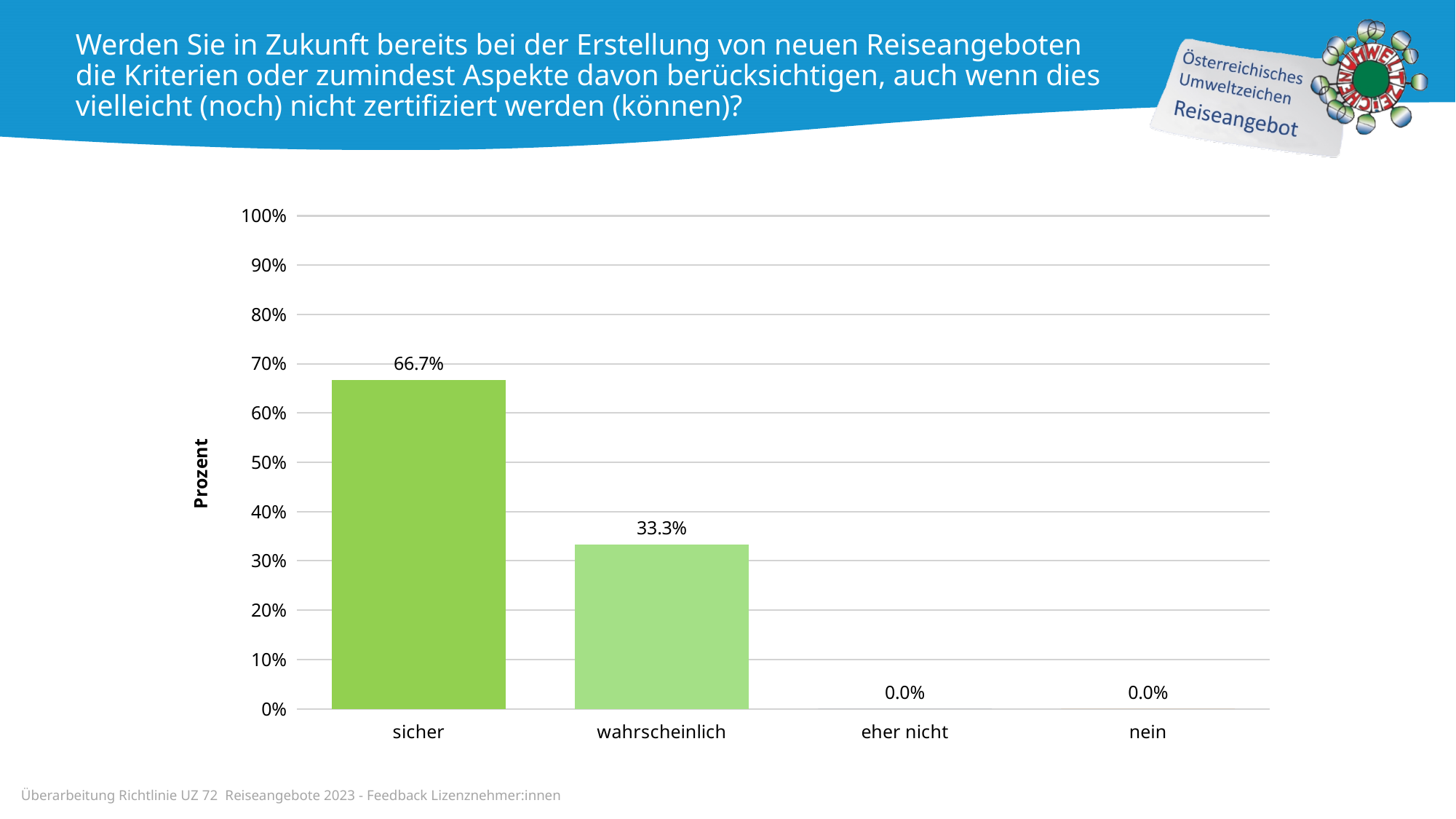
Is the value for "wahrscheinlich" greater or less than 40%? less What is the value for "eher nicht"? 0.0% What is the label of the vertical axis? Prozent Is the value for "sicher" greater or less than 60%? greater What is the difference between the values for "sicher" and "wahrscheinlich"? 33.4% What is the value for "sicher"? 66.7% How many categories are shown on the x axis? 4 Which is larger, the value for "sicher" or the value for "wahrscheinlich"? sicher What is the value for "wahrscheinlich"? 33.3% What is the value for "nein"? 0.0% What kind of chart is shown on the slide? bar chart Which category has the highest value? sicher